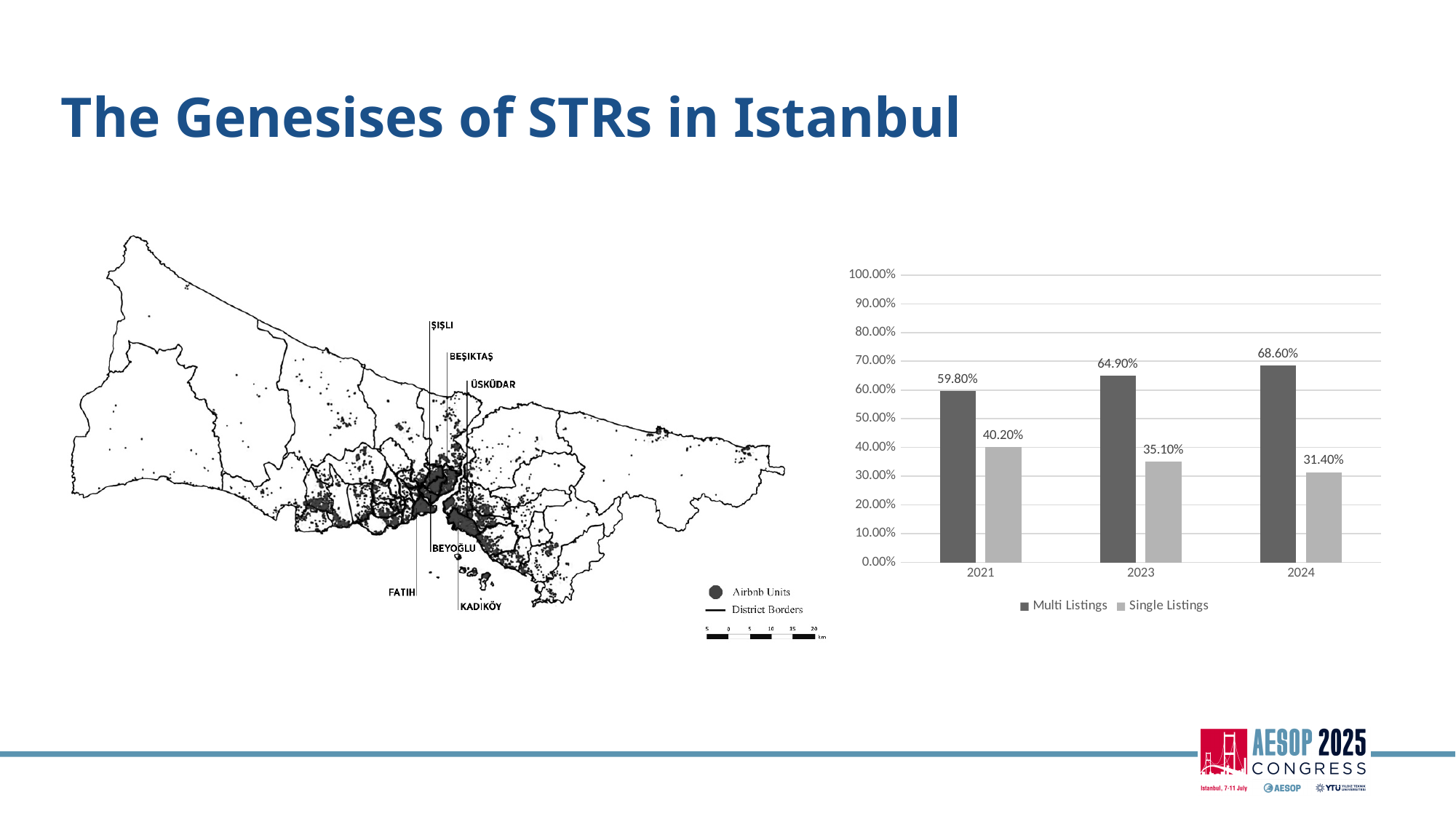
In which year is the Single Listings value lowest? 2024 In which year is the Multi Listings value highest? 2024 How many series does the legend of the bar chart list? 2 What is the value for Single Listings in 2023? 35.10% What is the value for Multi Listings in 2021? 59.80% What is the value for Multi Listings in 2024? 68.60% Do the Single Listings values rise or fall from 2021 to 2024? Fall What is the value for Single Listings in 2024? 31.40% How many years are shown on the x axis of the bar chart? 3 Which is larger in 2021, Multi Listings or Single Listings? Multi Listings What kind of chart is shown on the right of the slide? Bar chart What is the difference between Multi Listings and Single Listings in 2023? 29.80%